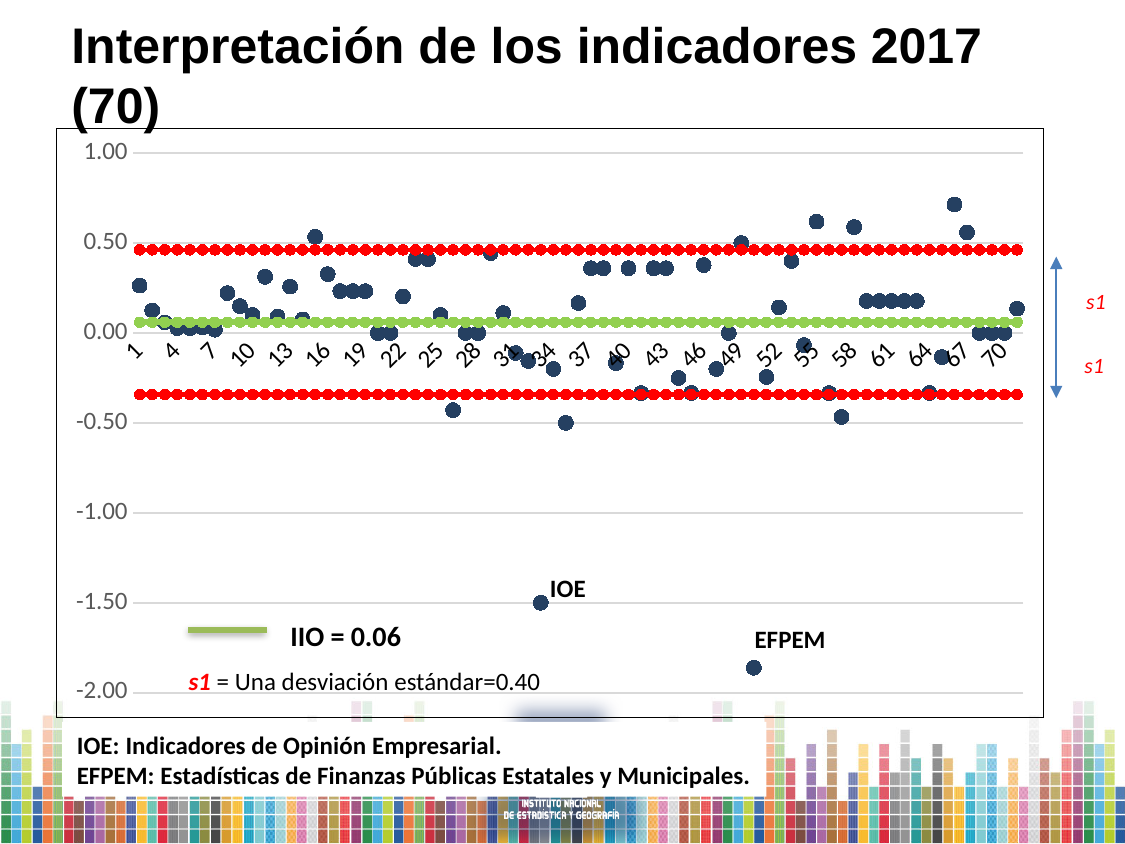
Is the value for the point labeled EFPEM greater or less than -1.50? less Is the value for indicator 1 greater or less than 0.00? greater What is the value of IIO shown in the chart legend? 0.06 What colour is the horizontal line representing IIO = 0.06? green Is the value for indicator 67 greater or less than 0.50? greater Which labeled point has the lowest value in the chart? EFPEM According to the chart, what is the value of one standard deviation (s1)? 0.40 What kind of chart is shown on the slide? scatter chart Which of the two labeled points, IOE or EFPEM, has the higher value? IOE What colour are the two horizontal lines marking one standard deviation (s1)? red